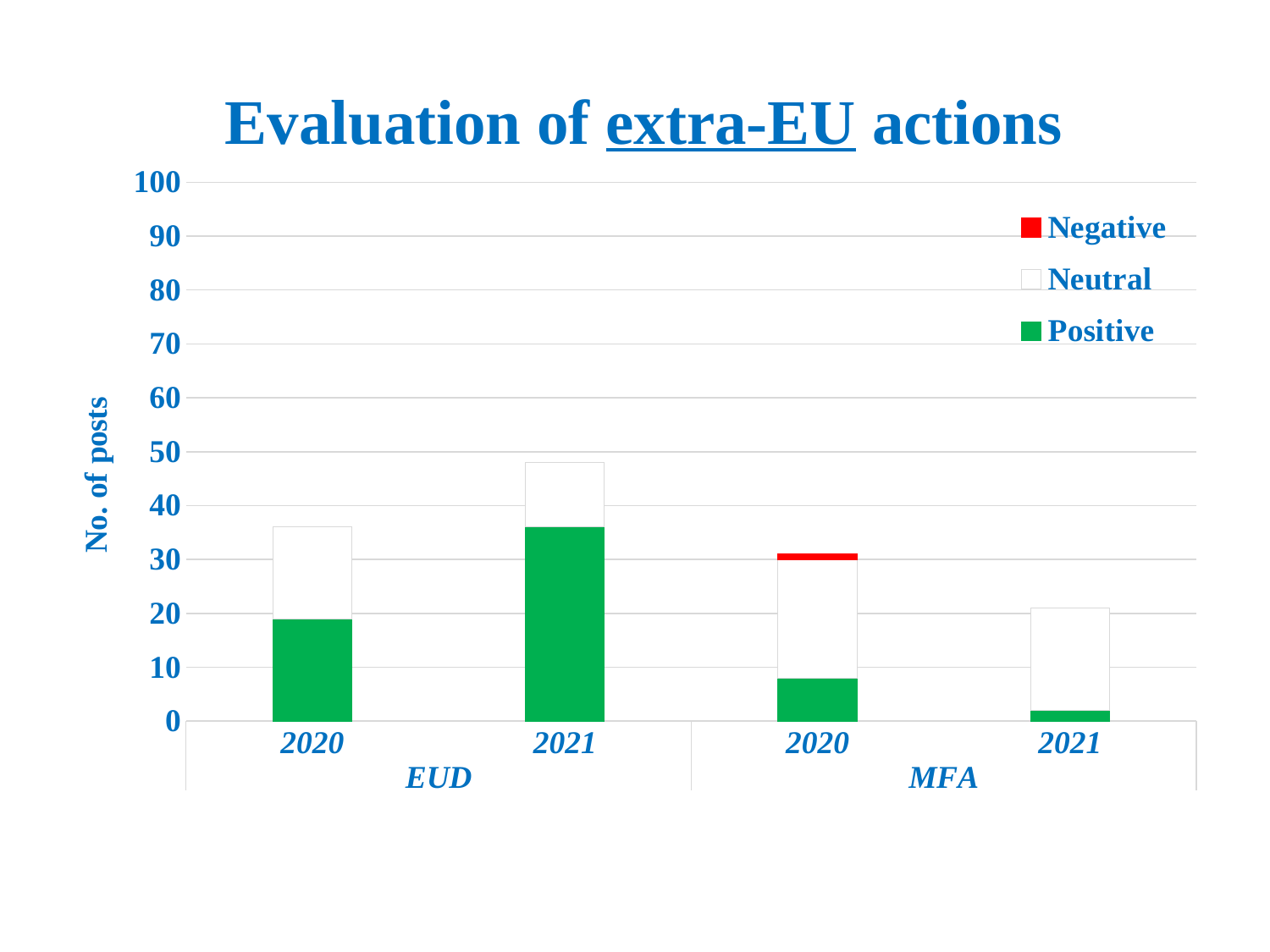
Is the total for EUD 2020 greater or less than 40? less How many bars are plotted in the chart? 4 Is the Positive value for MFA 2020 greater or less than 10? less Which bar has the lowest total number of posts? MFA 2021 Which is larger, the total for EUD 2020 or the total for MFA 2020? EUD 2020 What kind of chart is shown on the slide? Stacked bar chart Is the total for EUD 2021 greater or less than 40? greater Which bar has the highest total number of posts? EUD 2021 Which bar is the only one with a Negative segment? MFA 2020 Does the total number of posts for MFA rise or fall from 2020 to 2021? Fall How many series does the legend list? 3